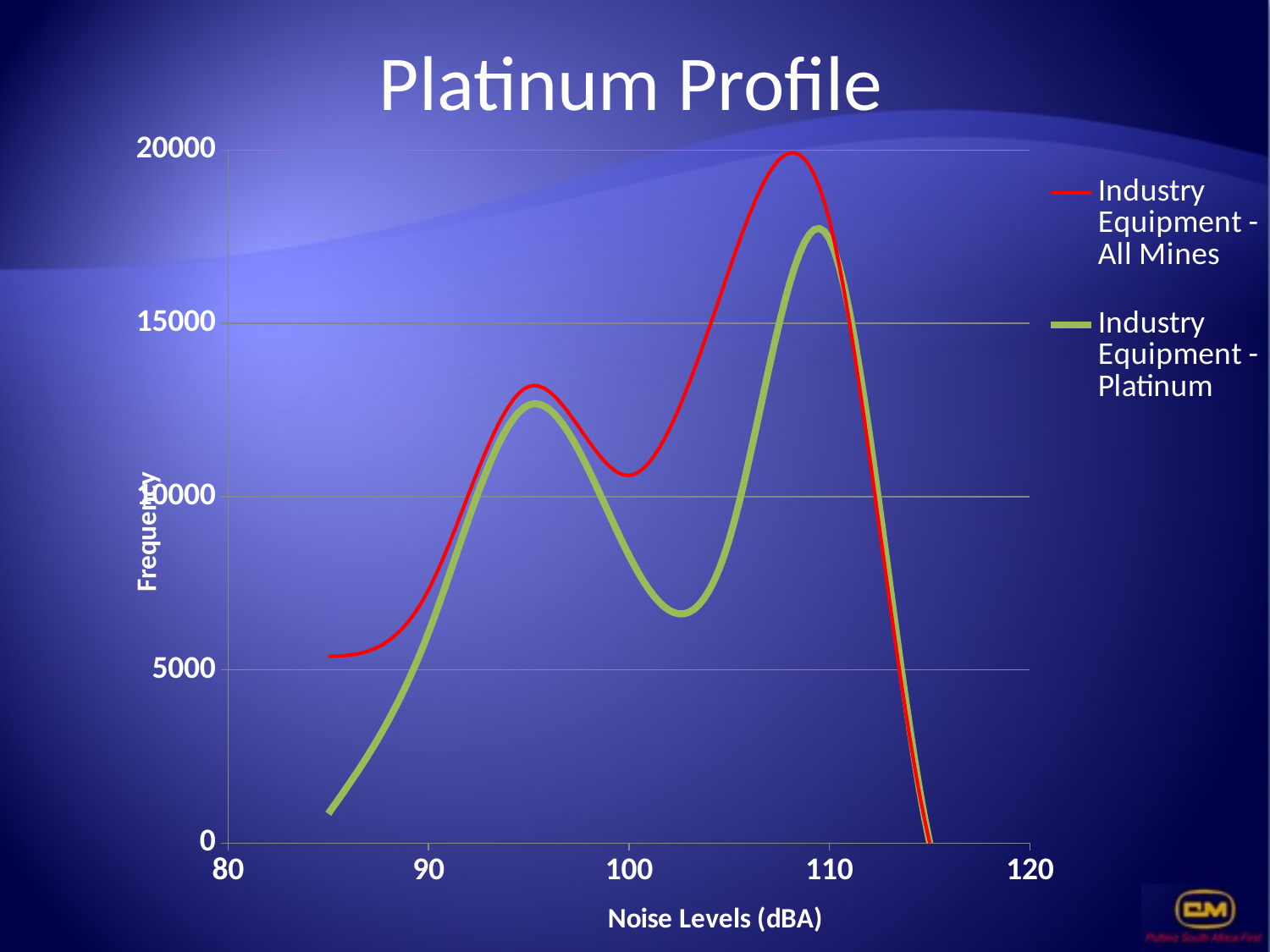
Is the value of the Industry Equipment - All Mines series at 90 dBA greater or less than 5000? greater How many series does the legend list? 2 Is the value of the Industry Equipment - Platinum series at 100 dBA greater or less than 10000? less At 90 dBA, which series has the higher value, Industry Equipment - All Mines or Industry Equipment - Platinum? Industry Equipment - All Mines Is the peak value of the Industry Equipment - Platinum series greater or less than 15000? greater Which series reaches the higher peak, Industry Equipment - All Mines or Industry Equipment - Platinum? Industry Equipment - All Mines What is the label of the x axis? Noise Levels (dBA) What kind of chart is shown on the slide? line chart What is the title of the chart? Platinum Profile Between 110 and 115 dBA, do the values of the Industry Equipment - Platinum series rise or fall? fall